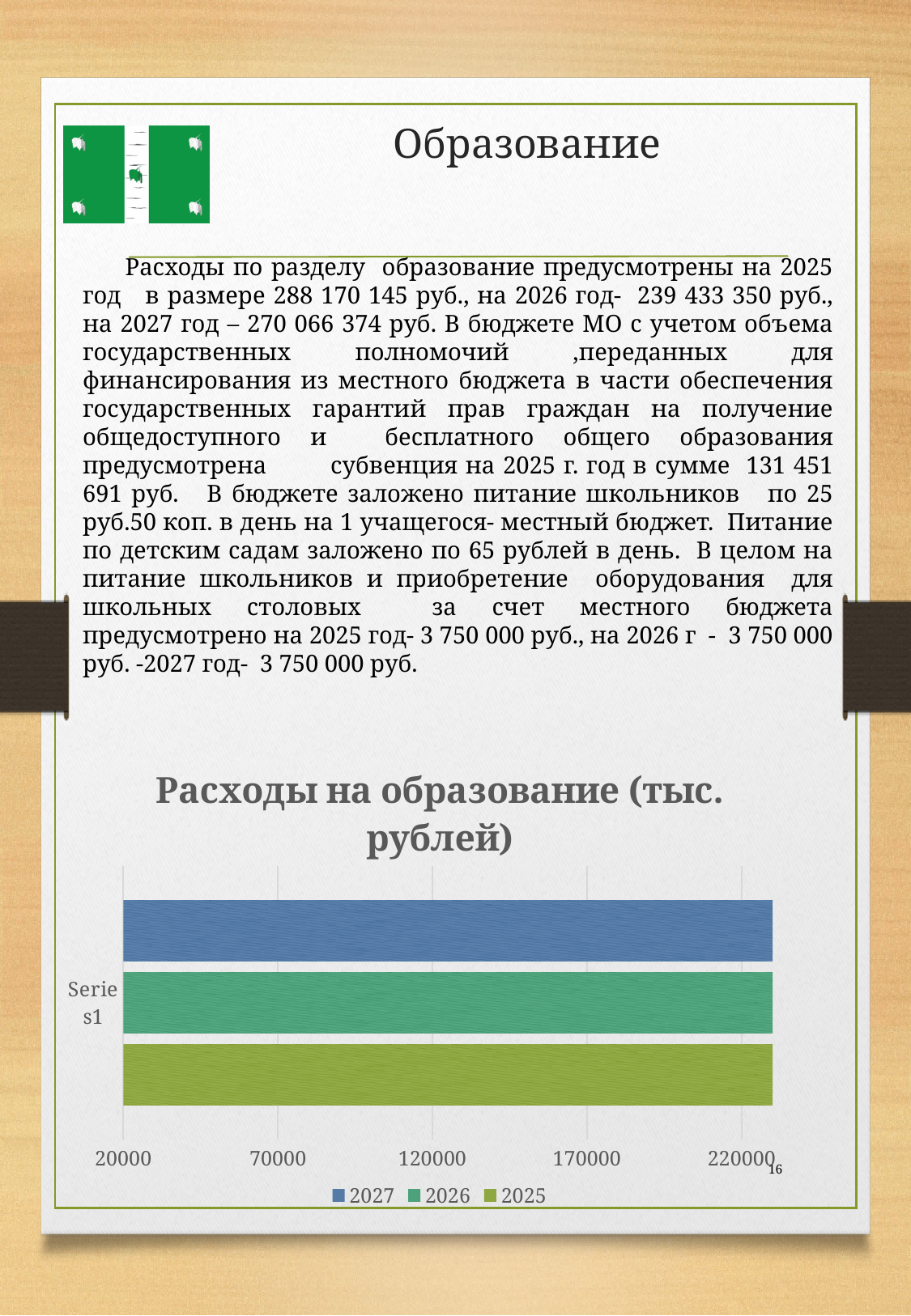
Is the value for the 2026 series greater or less than 120000? greater What is the highest tick value shown on the horizontal axis of the chart? 220000 What is the title of the chart? Расходы на образование (тыс. рублей) What kind of chart is shown on the slide? bar chart How many categories are shown on the vertical axis of the chart? 1 How many series does the chart legend list? 3 What is the lowest tick value shown on the horizontal axis of the chart? 20000 Is the value for the 2027 series greater or less than 170000? greater Which series are listed in the chart legend? 2027, 2026, 2025